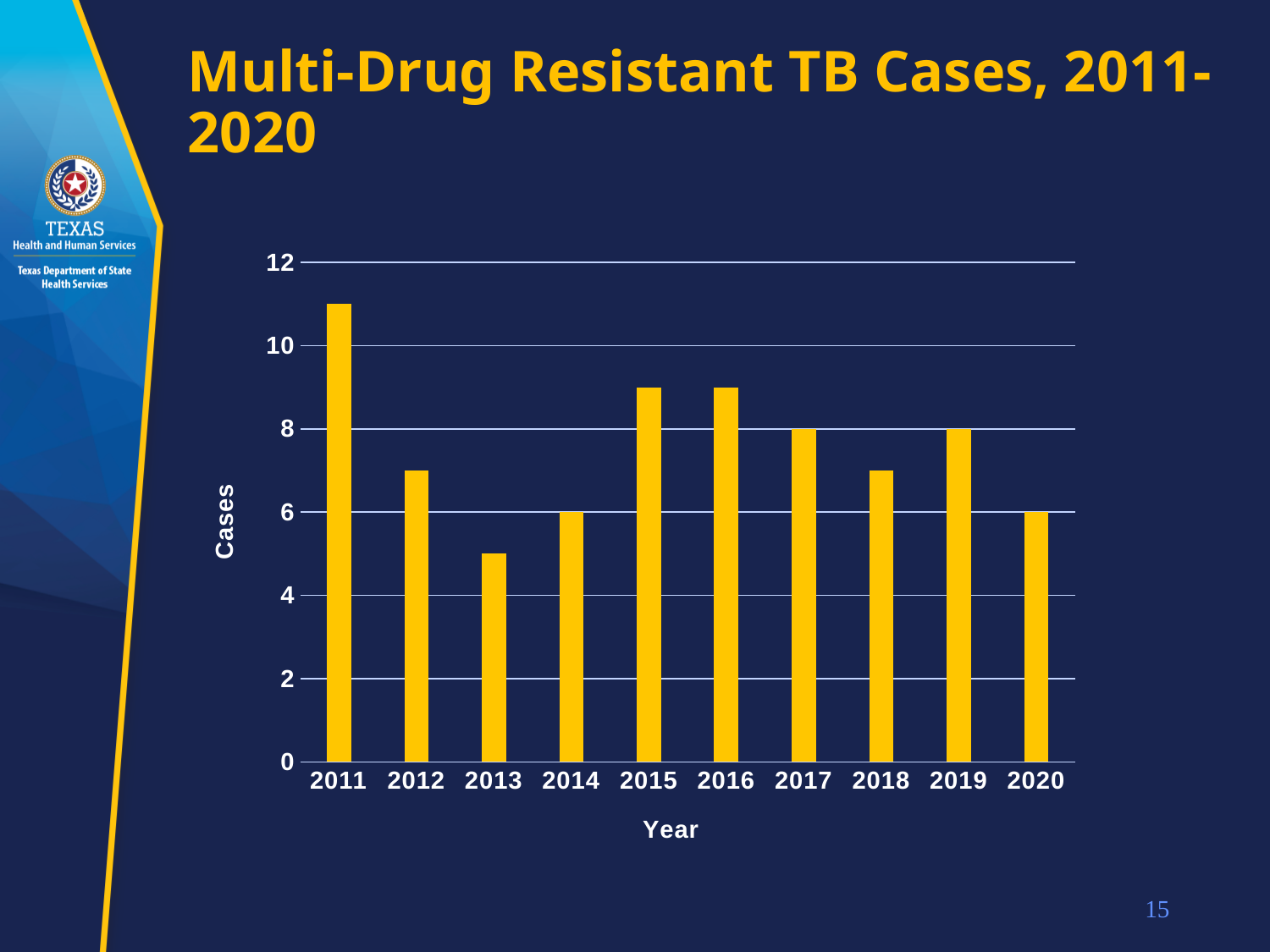
What kind of chart is shown on the slide? bar chart How many cases are shown for 2017? 8 How many cases are shown for 2014? 6 Which year has the lowest number of multi-drug resistant TB cases? 2013 What is the difference between the number of cases in 2017 and in 2014? 2 Which year has more cases, 2011 or 2012? 2011 What is the label on the vertical axis of the chart? Cases How many years are shown on the x axis of the chart? 10 Which year has the highest number of multi-drug resistant TB cases? 2011 Is the value for 2011 greater or less than 10? greater Is the value for 2013 greater or less than 6? less How many cases are shown for 2020? 6